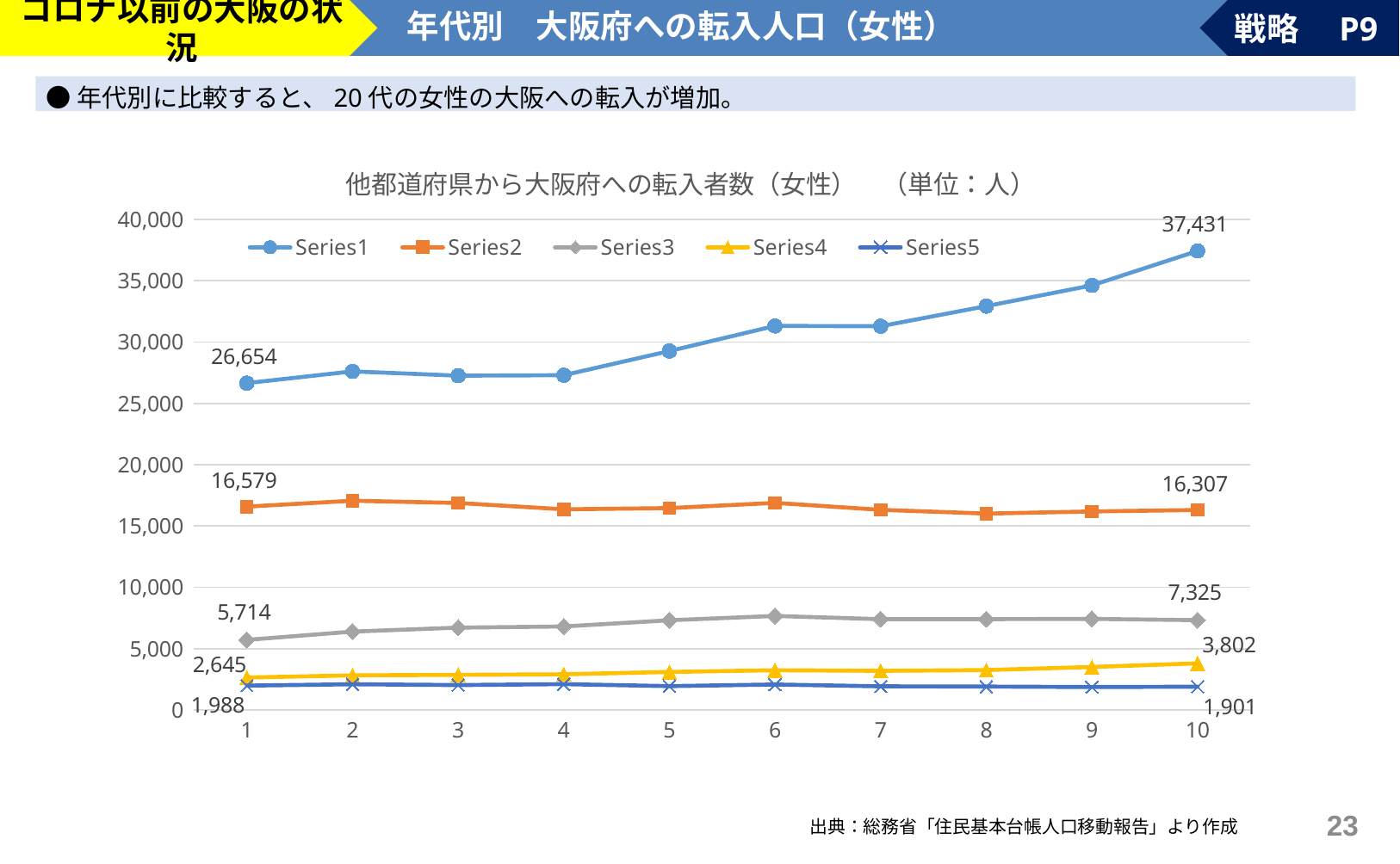
Which series has the highest values across the chart? Series1 How many points are plotted along the x axis for each series? 10 Does Series1 generally rise or fall from x = 1 to x = 10? rise What is the difference between Series4 at x = 10 and Series4 at x = 1? 1,157 What is the value of Series1 at x = 10? 37,431 By how much did Series1 change from x = 1 to x = 10? 10,777 What is the value of Series2 at x = 1? 16,579 What is the value of Series3 at x = 10? 7,325 What type of chart is shown on the slide? line chart How many series does the legend list? 5 Is the value of Series1 at x = 6 greater or less than 30,000? greater What is the value of Series5 at x = 1? 1,988